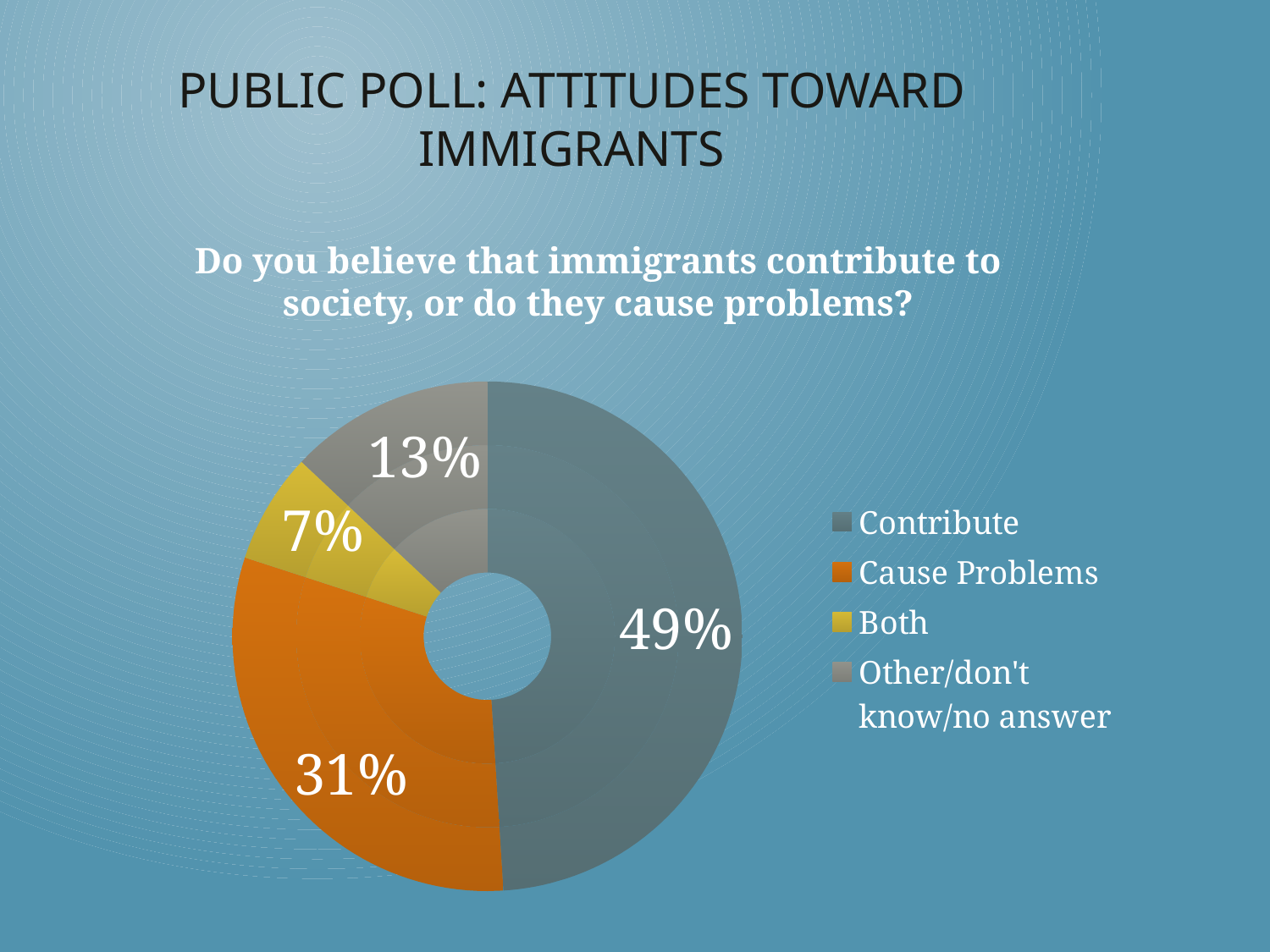
What percentage of respondents answered "Both"? 7% What percentage of respondents answered "Cause Problems"? 31% What is the combined share of "Contribute" and "Both"? 56% What kind of chart is shown on the slide? Pie chart (doughnut) How many response categories are shown in the chart? 4 What colour represents "Cause Problems" in the chart? Orange What percentage of respondents answered "Other/don't know/no answer"? 13% Which response has the smallest share of the pie? Both What is the difference in percentage points between "Contribute" and "Cause Problems"? 18 What percentage of respondents answered "Contribute"? 49% Which is larger: the share for "Other/don't know/no answer" or the share for "Both"? Other/don't know/no answer Which response has the largest share of the pie? Contribute